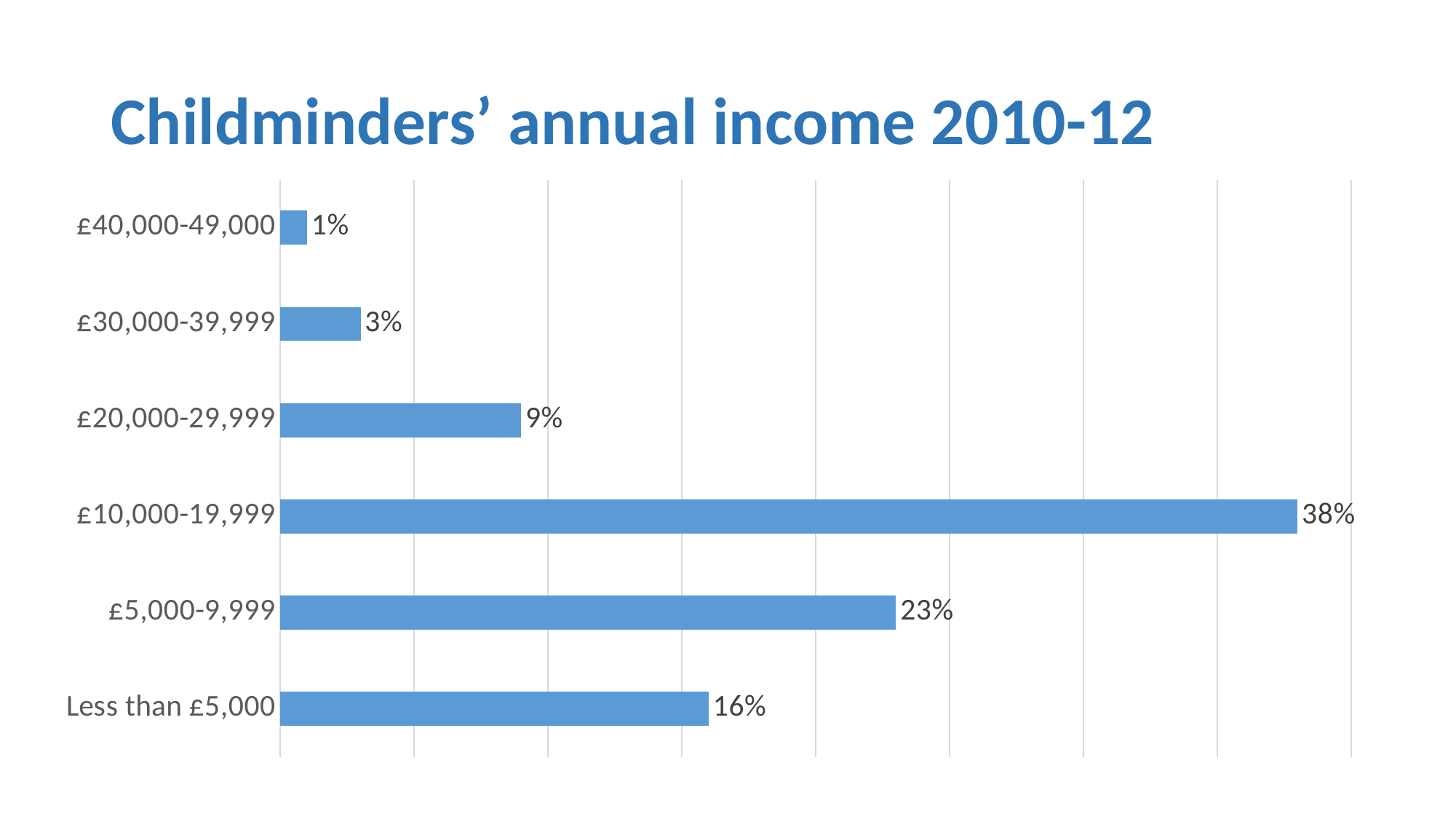
What is the title of the chart? Childminders' annual income 2010-12 What is the value shown for the £5,000-9,999 income band? 23% Which income band has the lowest percentage of childminders? £40,000-49,000 What is the value for the £30,000-39,999 income band? 3% Which has a larger value: Less than £5,000 or £20,000-29,999? Less than £5,000 What is the difference in percentage points between the £20,000-29,999 band and the £30,000-39,999 band? 6 What is the difference in percentage points between the £10,000-19,999 band and the £5,000-9,999 band? 15 How many income bands are shown in the chart? 6 What percentage of childminders earned less than £5,000? 16% What percentage of childminders had an annual income of £10,000-19,999? 38% Which income band has the highest percentage of childminders? £10,000-19,999 What kind of chart is shown on the slide? Bar chart